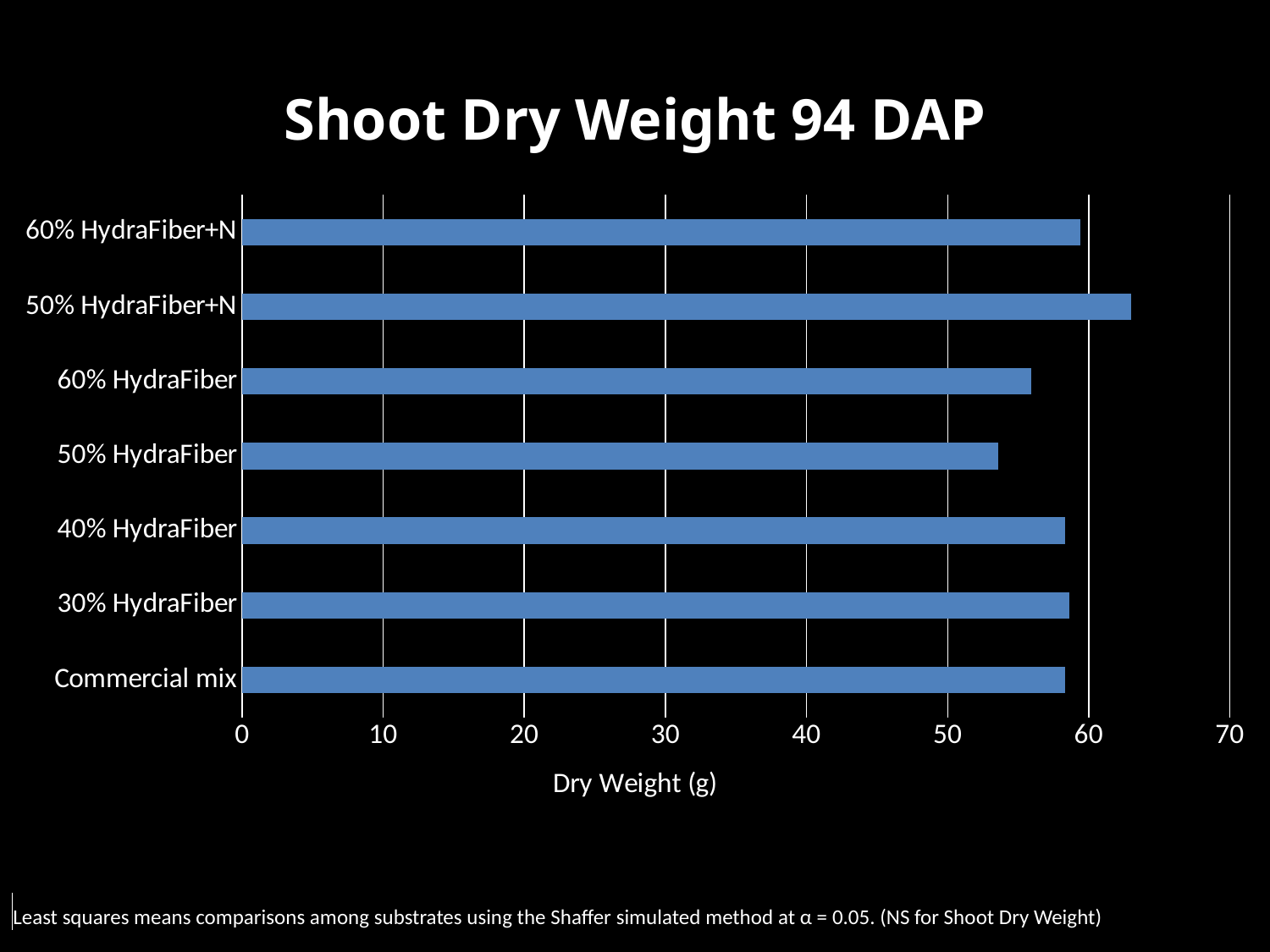
What kind of chart is shown on the slide? Bar chart Is the value for Commercial mix greater or less than 50? greater Is the value for 60% HydraFiber greater or less than 60? less Which substrate has the lowest shoot dry weight? 50% HydraFiber What is the title of the chart? Shoot Dry Weight 94 DAP Is the value for 50% HydraFiber greater or less than 60? less How many substrate categories are plotted in the chart? 7 What is the label on the horizontal axis of the chart? Dry Weight (g) Which has a larger shoot dry weight, 60% HydraFiber or 50% HydraFiber? 60% HydraFiber Which has a larger shoot dry weight, 50% HydraFiber+N or 60% HydraFiber+N? 50% HydraFiber+N Which substrate has the highest shoot dry weight? 50% HydraFiber+N